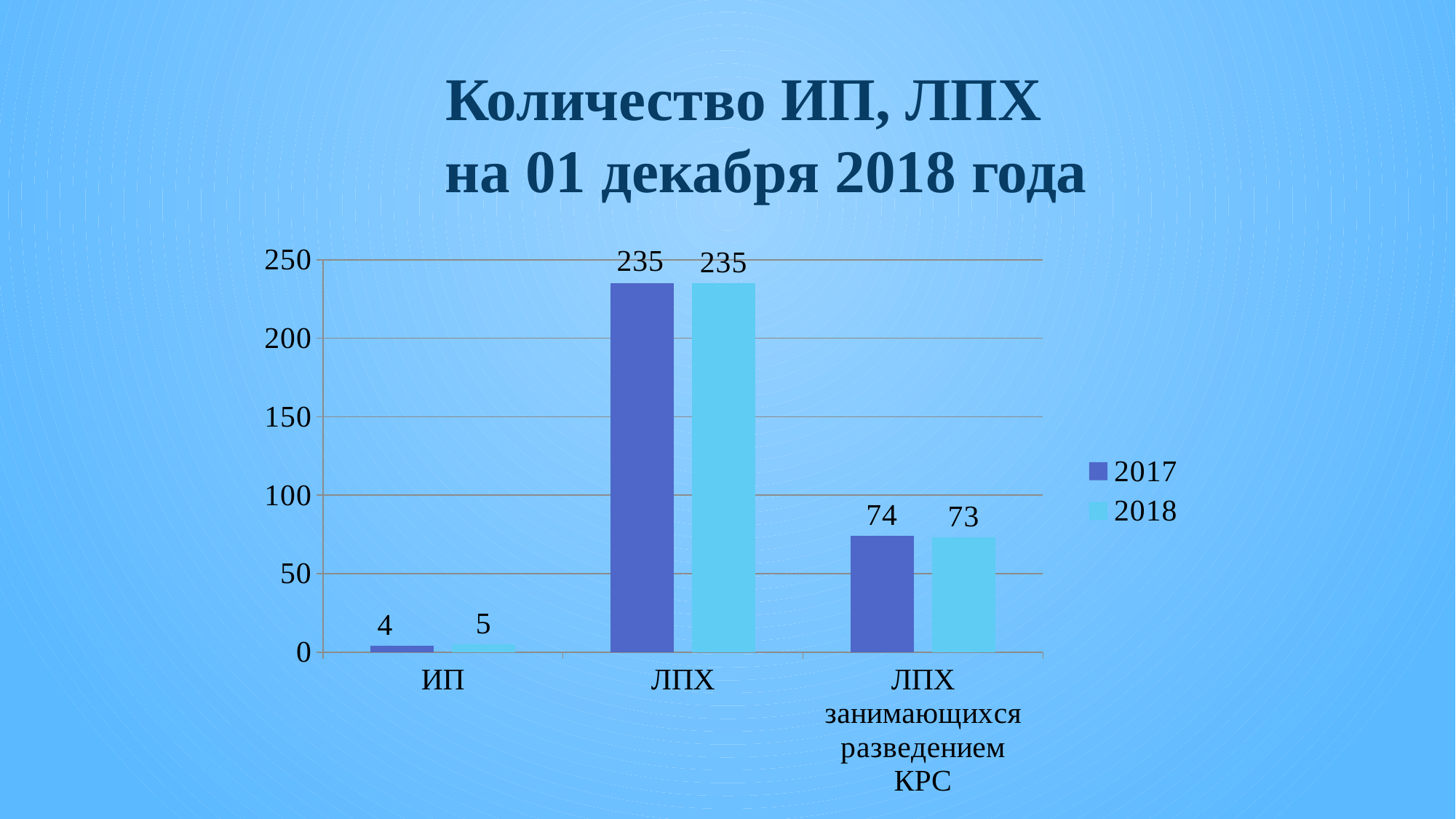
What is the difference between the ЛПХ and ИП values in 2017? 231 What is the value for ЛПХ in 2018? 235 What is the difference between the 2017 and 2018 values for ЛПХ занимающихся разведением КРС? 1 What is the value for ЛПХ занимающихся разведением КРС in 2017? 74 How many series does the legend list? 2 Which is larger for ИП: the 2017 value or the 2018 value? 2018 Which category has the lowest value in 2018? ИП How many categories are shown on the x axis? 3 Which category has the highest value in 2017? ЛПХ What type of chart is shown on the slide? Bar chart What is the value for ИП in 2017? 4 What is the value for ИП in 2018? 5